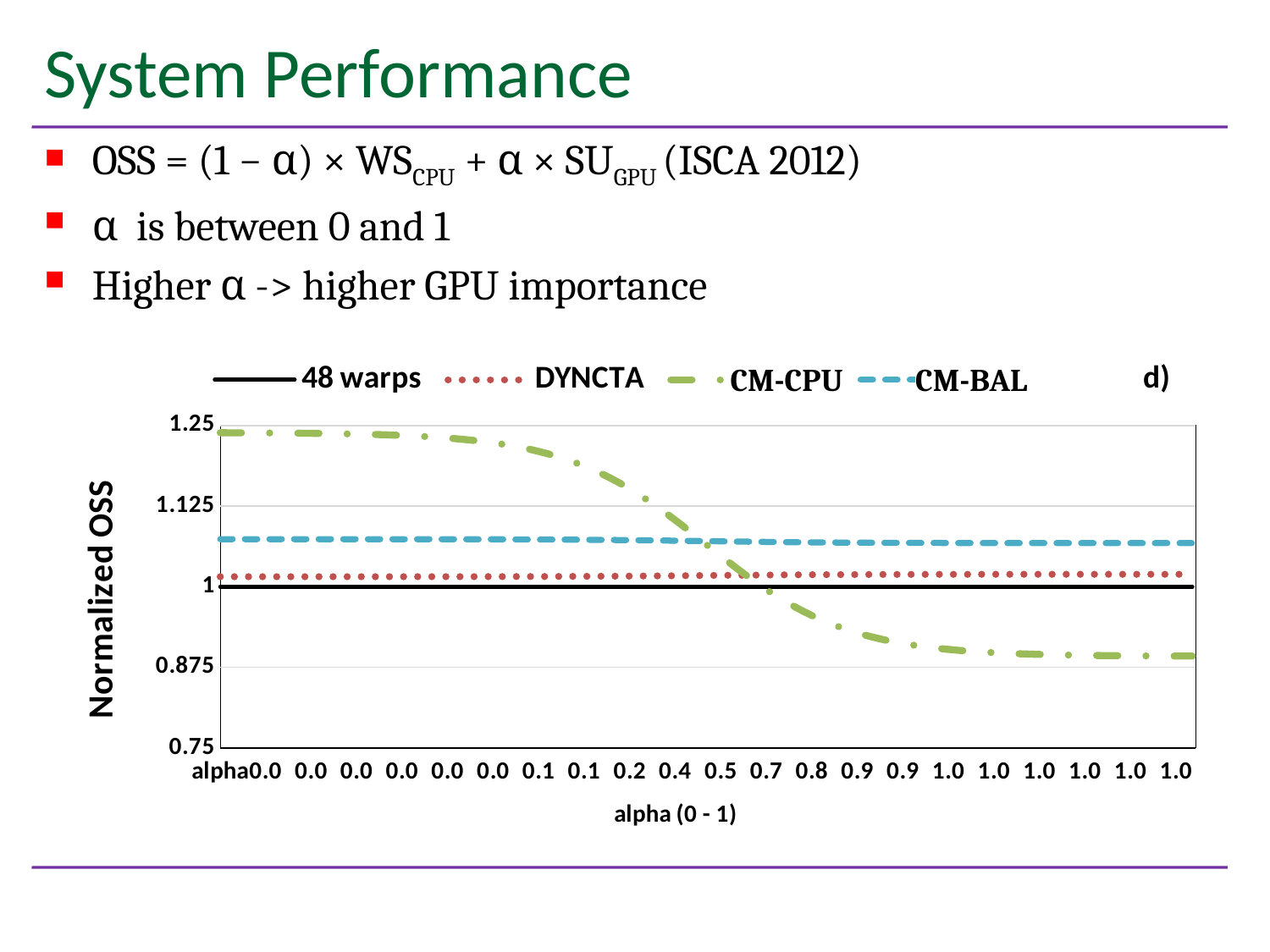
What is the Normalized OSS value of the 48 warps series? 1 Is the Normalized OSS of CM-CPU at alpha 0.0 greater or less than 1.125? greater Which series has the lowest Normalized OSS at alpha 1.0? CM-CPU What is the title of the x axis of the chart? alpha (0 - 1) Is the Normalized OSS of CM-CPU at alpha 1.0 greater or less than 1? less Does the CM-CPU series rise or fall as alpha increases from 0.0 to 1.0? fall Is the Normalized OSS of CM-BAL greater or less than 1.125? less Which series has the highest Normalized OSS at alpha 0.0? CM-CPU What kind of chart is shown on the slide? line chart At alpha 1.0, which series has the larger Normalized OSS, CM-BAL or CM-CPU? CM-BAL How many series does the chart legend list? 4 What is the title of the y axis of the chart? Normalized OSS